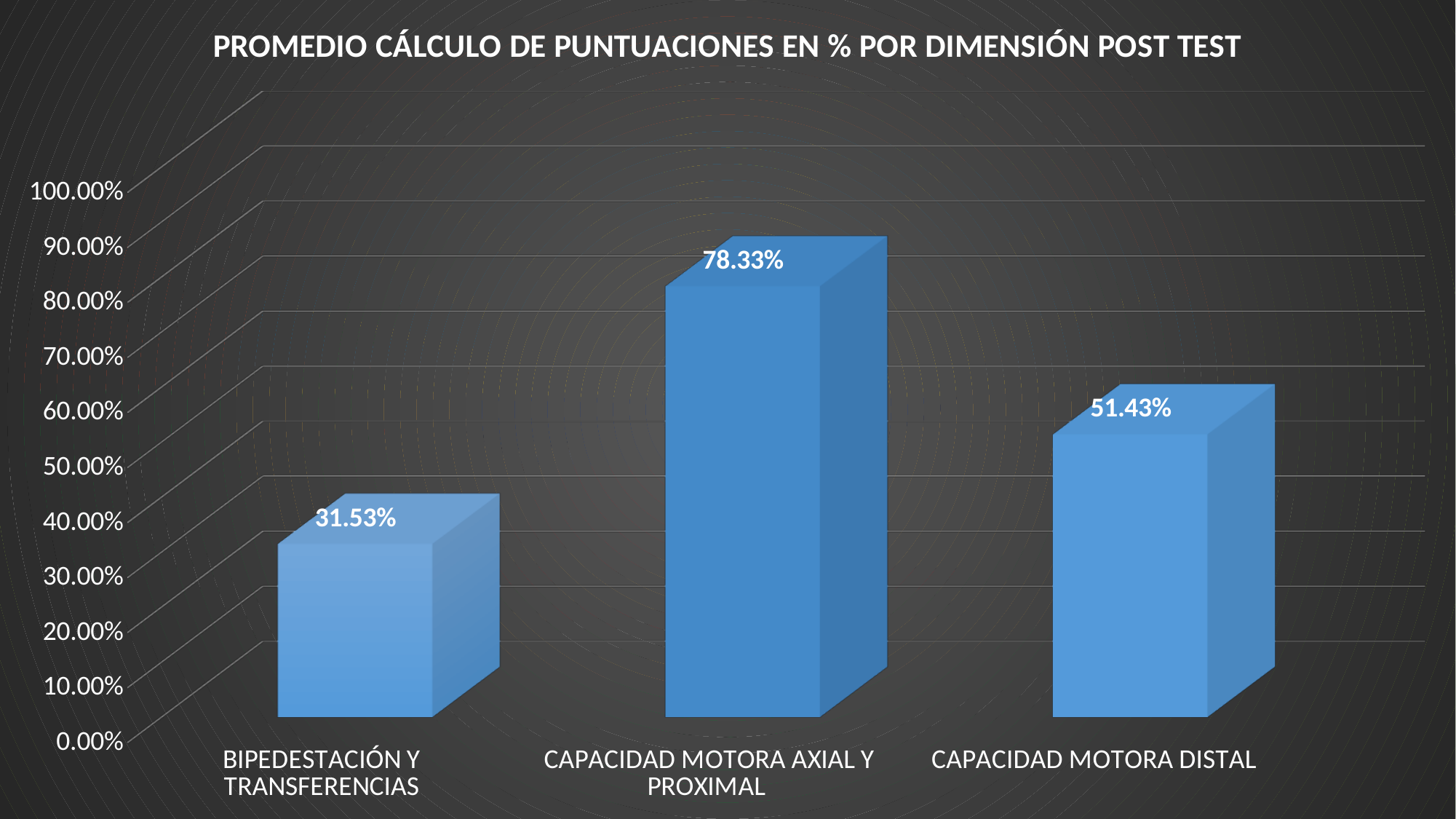
What is the difference between the values for CAPACIDAD MOTORA DISTAL and BIPEDESTACIÓN Y TRANSFERENCIAS? 19.90% What is the difference between the values for CAPACIDAD MOTORA AXIAL Y PROXIMAL and CAPACIDAD MOTORA DISTAL? 26.90% How many categories are shown on the x axis? 3 Which is larger, the value for CAPACIDAD MOTORA DISTAL or the value for BIPEDESTACIÓN Y TRANSFERENCIAS? CAPACIDAD MOTORA DISTAL What is the value for CAPACIDAD MOTORA DISTAL? 51.43% What kind of chart is shown on the slide? Bar chart What is the title of the chart? PROMEDIO CÁLCULO DE PUNTUACIONES EN % POR DIMENSIÓN POST TEST What is the value for BIPEDESTACIÓN Y TRANSFERENCIAS? 31.53% Which category has the lowest value? BIPEDESTACIÓN Y TRANSFERENCIAS Is the value for CAPACIDAD MOTORA AXIAL Y PROXIMAL greater or less than 70.00%? greater What is the value for CAPACIDAD MOTORA AXIAL Y PROXIMAL? 78.33% Which category has the highest value? CAPACIDAD MOTORA AXIAL Y PROXIMAL